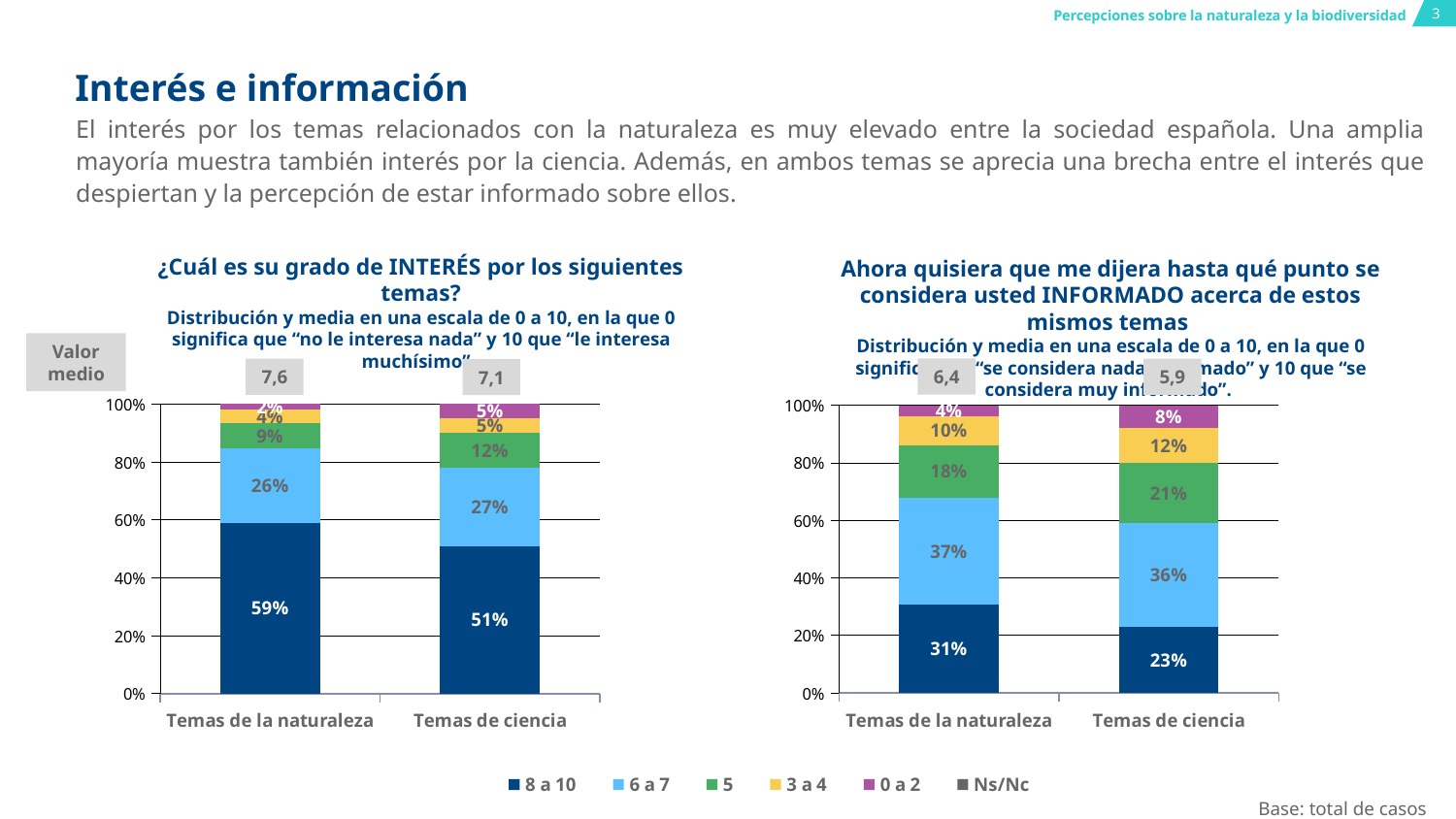
In the right chart (INFORMADO), what is the mean value shown for 'Temas de ciencia'? 5,9 In the right chart (INFORMADO), what is the '6 a 7' share for 'Temas de la naturaleza'? 37% In the right chart (INFORMADO), what is the difference between the '8 a 10' shares for 'Temas de la naturaleza' and 'Temas de ciencia'? 8 percentage points In the left chart (grado de INTERÉS), what is the '6 a 7' share for 'Temas de ciencia'? 27% In the left chart (grado de INTERÉS), what percentage of respondents rated 'Temas de la naturaleza' 8 a 10? 59% In the left chart (grado de INTERÉS), which topic has the larger '8 a 10' share, 'Temas de la naturaleza' or 'Temas de ciencia'? Temas de la naturaleza In the right chart (INFORMADO), what is the '0 a 2' share for 'Temas de ciencia'? 8% In the right chart (INFORMADO), what percentage of respondents rated 'Temas de ciencia' 8 a 10? 23% What kind of chart is used on the slide? Stacked bar chart In the left chart (grado de INTERÉS), what is the mean value (valor medio) shown for 'Temas de la naturaleza'? 7,6 In the left chart (grado de INTERÉS), what percentage of respondents rated 'Temas de ciencia' 8 a 10? 51% How many series does the legend list? 6